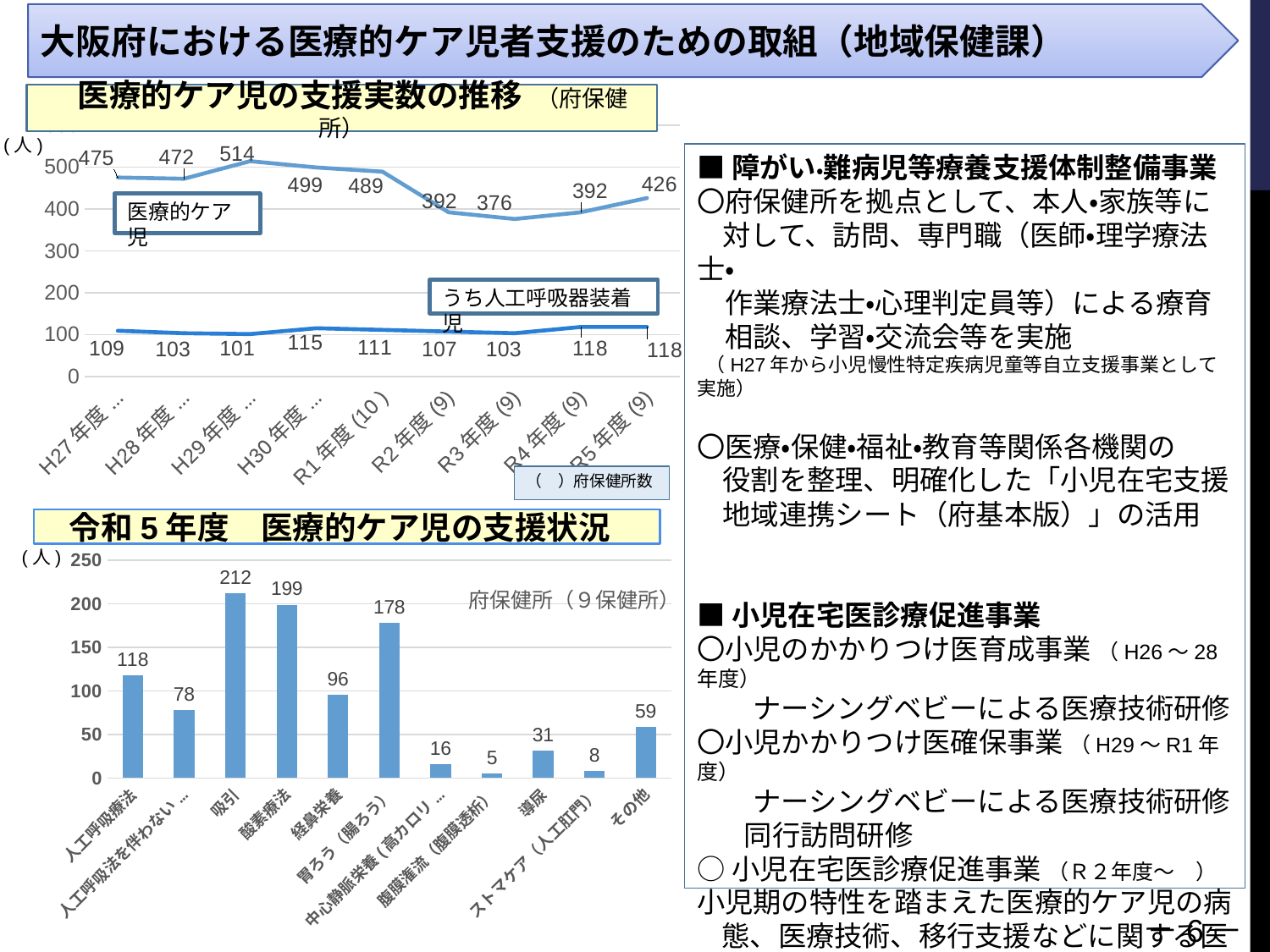
In the bottom chart '令和5年度 医療的ケア児の支援状況', what is the value for 吸引? 212 In the bottom chart '令和5年度 医療的ケア児の支援状況', what kind of chart is it? Bar chart In the top chart '医療的ケア児の支援実数の推移', in which year is the 医療的ケア児 value highest? H29年度 In the top chart '医療的ケア児の支援実数の推移', what is the value for 医療的ケア児 in R5年度? 426 In the bottom chart '令和5年度 医療的ケア児の支援状況', which category has the lowest value? 腹膜潅流（腹膜透析） In the top chart '医療的ケア児の支援実数の推移', what is the difference between the 医療的ケア児 values for H29年度 and R3年度? 138 In the bottom chart '令和5年度 医療的ケア児の支援状況', which is larger, 酸素療法 or 胃ろう（腸ろう）? 酸素療法 In the top chart '医療的ケア児の支援実数の推移', what is the value for うち人工呼吸器装着児 in R1年度? 111 In the bottom chart '令和5年度 医療的ケア児の支援状況', how many categories are shown? 11 In the bottom chart '令和5年度 医療的ケア児の支援状況', what is the difference between 人工呼吸療法 and その他? 59 In the top chart '医療的ケア児の支援実数の推移', in which year is the 医療的ケア児 value lowest? R3年度 In the top chart '医療的ケア児の支援実数の推移', what kind of chart is it? Line chart